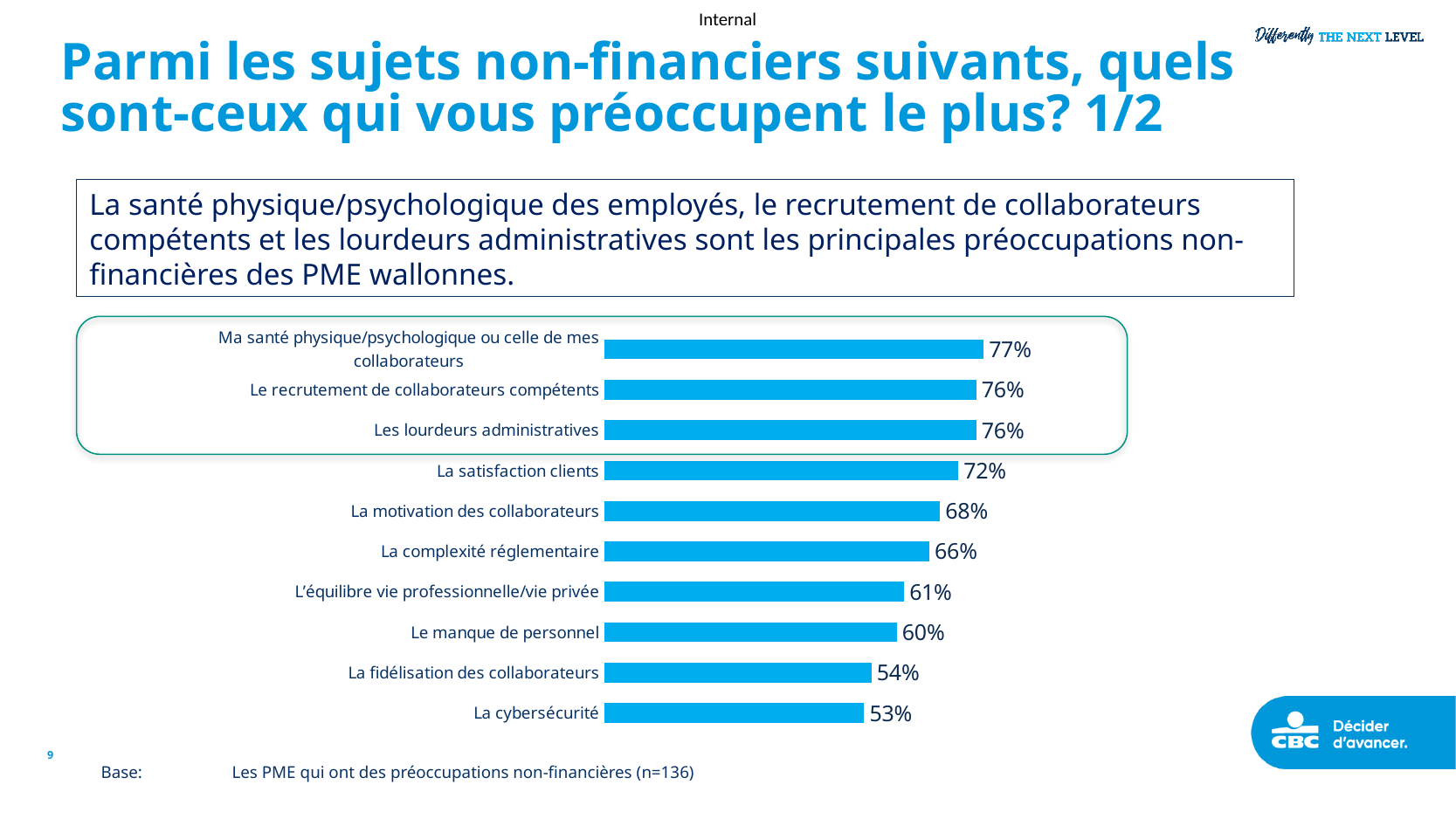
Which category has the highest value? Ma santé physique/psychologique ou celle de mes collaborateurs How many categories are shown in the chart? 10 What is the value for "La satisfaction clients"? 72% What kind of chart is shown on the slide? Bar chart What is the value for "Le manque de personnel"? 60% What is the value for "La cybersécurité"? 53% Which category has the lowest value? La cybersécurité What is the value for "La complexité réglementaire"? 66% What is the difference between the highest and lowest values in the chart? 24% Which is larger: the value for "L'équilibre vie professionnelle/vie privée" or the value for "La fidélisation des collaborateurs"? L'équilibre vie professionnelle/vie privée How many categories are enclosed in the highlighted box at the top of the chart? 3 What is the difference between the values for "La motivation des collaborateurs" and "La fidélisation des collaborateurs"? 14%